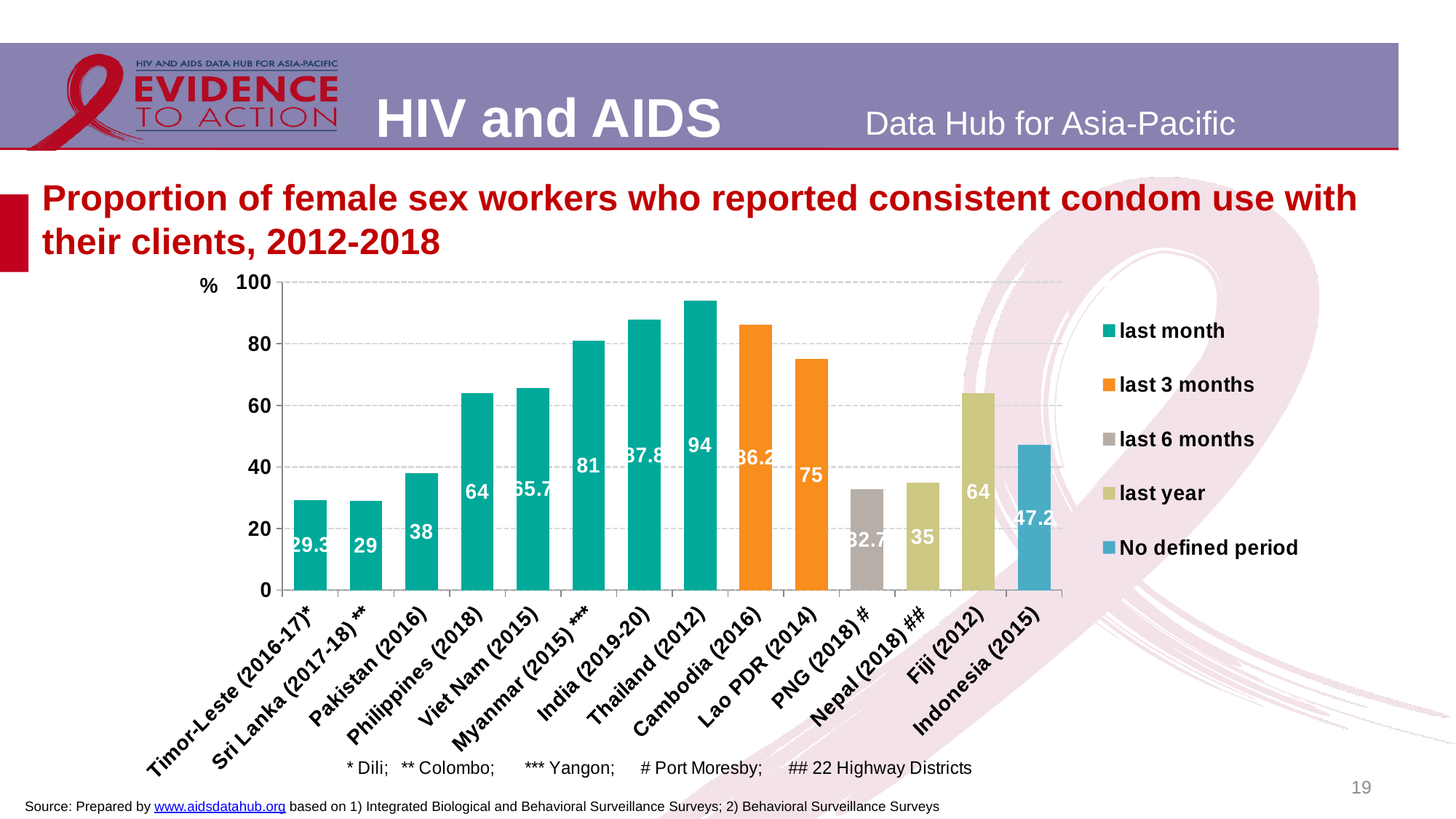
What is the value for Fiji (2012)? 64 Is the value for Nepal (2018) greater or less than 40? less What is the value for Myanmar (2015)? 81 What kind of chart is shown on the slide? Bar chart What is the value for Pakistan (2016)? 38 Which legend category does the bar for Cambodia (2016) belong to? last 3 months What is the difference between the values for Thailand (2012) and Myanmar (2015)? 13 What is the value for Lao PDR (2014)? 75 Which country has the highest proportion of female sex workers reporting consistent condom use? Thailand (2012) Which is larger, the value for Philippines (2018) or Viet Nam (2015)? Viet Nam (2015) How many entries does the legend list? 5 How many countries are shown on the x axis of the chart? 14